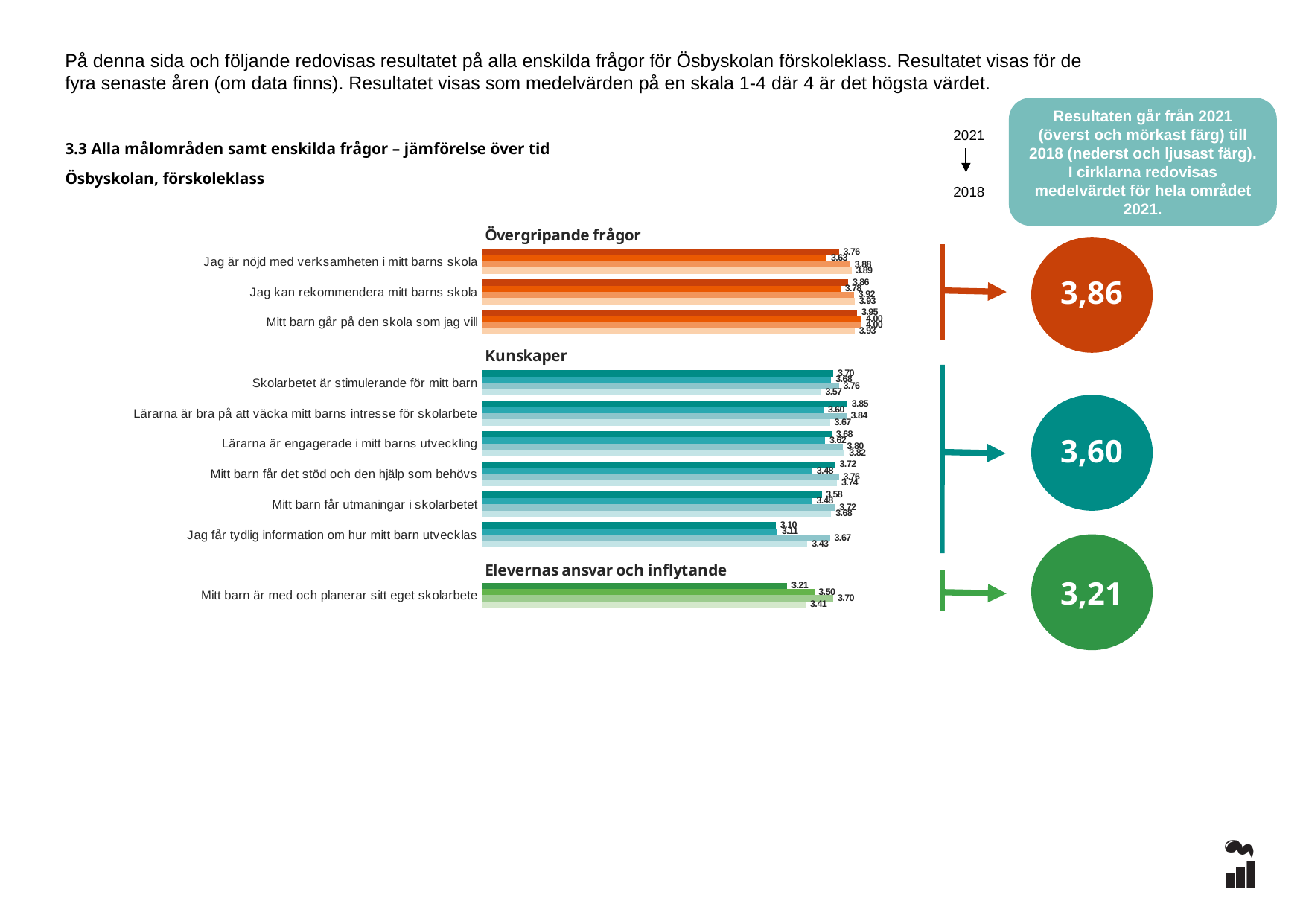
How many years (bars per question) are shown for each question in the charts? 4 How many questions (categories) are shown in the Kunskaper chart? 6 Which is larger: the 2021 value for "Jag kan rekommendera mitt barns skola" or the 2021 value for "Mitt barn är med och planerar sitt eget skolarbete"? Jag kan rekommendera mitt barns skola In the Kunskaper chart, what is the 2018 (bottom, lightest bar) value for "Skolarbetet är stimulerande för mitt barn"? 3.57 In the Kunskaper chart, which question has the highest 2021 (topmost bar) value? Lärarna är bra på att väcka mitt barns intresse för skolarbete In the Elevernas ansvar och inflytande chart, what is the 2021 (topmost, darkest bar) value for "Mitt barn är med och planerar sitt eget skolarbete"? 3.21 What is the 2021 mean value shown in the circle for the Kunskaper area? 3,60 In the Kunskaper chart, which question has the lowest 2021 (topmost bar) value? Jag får tydlig information om hur mitt barn utvecklas In the Kunskaper chart, what is the 2021 (topmost, darkest bar) value for "Jag får tydlig information om hur mitt barn utvecklas"? 3.10 In the Övergripande frågor chart, what is the 2021 (topmost, darkest bar) value for "Jag kan rekommendera mitt barns skola"? 3.86 What type of chart is used to show the results for the individual questions? Bar chart In the Kunskaper chart, what is the difference between the 2021 value for "Lärarna är bra på att väcka mitt barns intresse för skolarbete" (3.85) and the 2021 value for "Jag får tydlig information om hur mitt barn utvecklas" (3.10)? 0.75